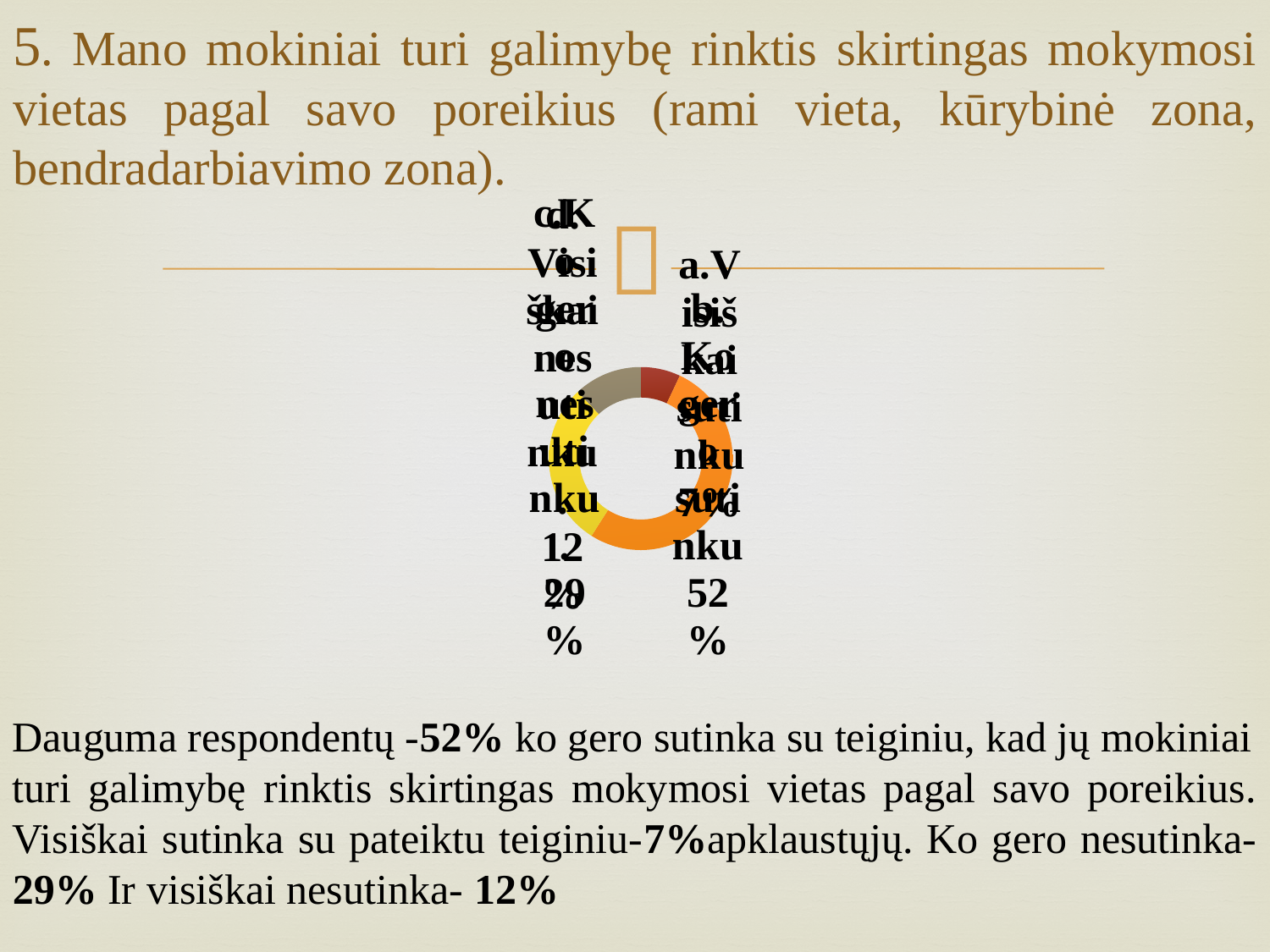
How many slices does the doughnut chart have? 4 What colour is the largest slice of the doughnut chart? orange Which slice of the doughnut chart is the smallest? the dark red slice Which slice is larger in the doughnut chart, the orange one or the yellow one? the orange one What share of the doughnut chart does the largest (orange) slice represent? 52% What kind of chart is shown on the slide? doughnut (pie) chart What is the value of the largest slice in the doughnut chart? 52%